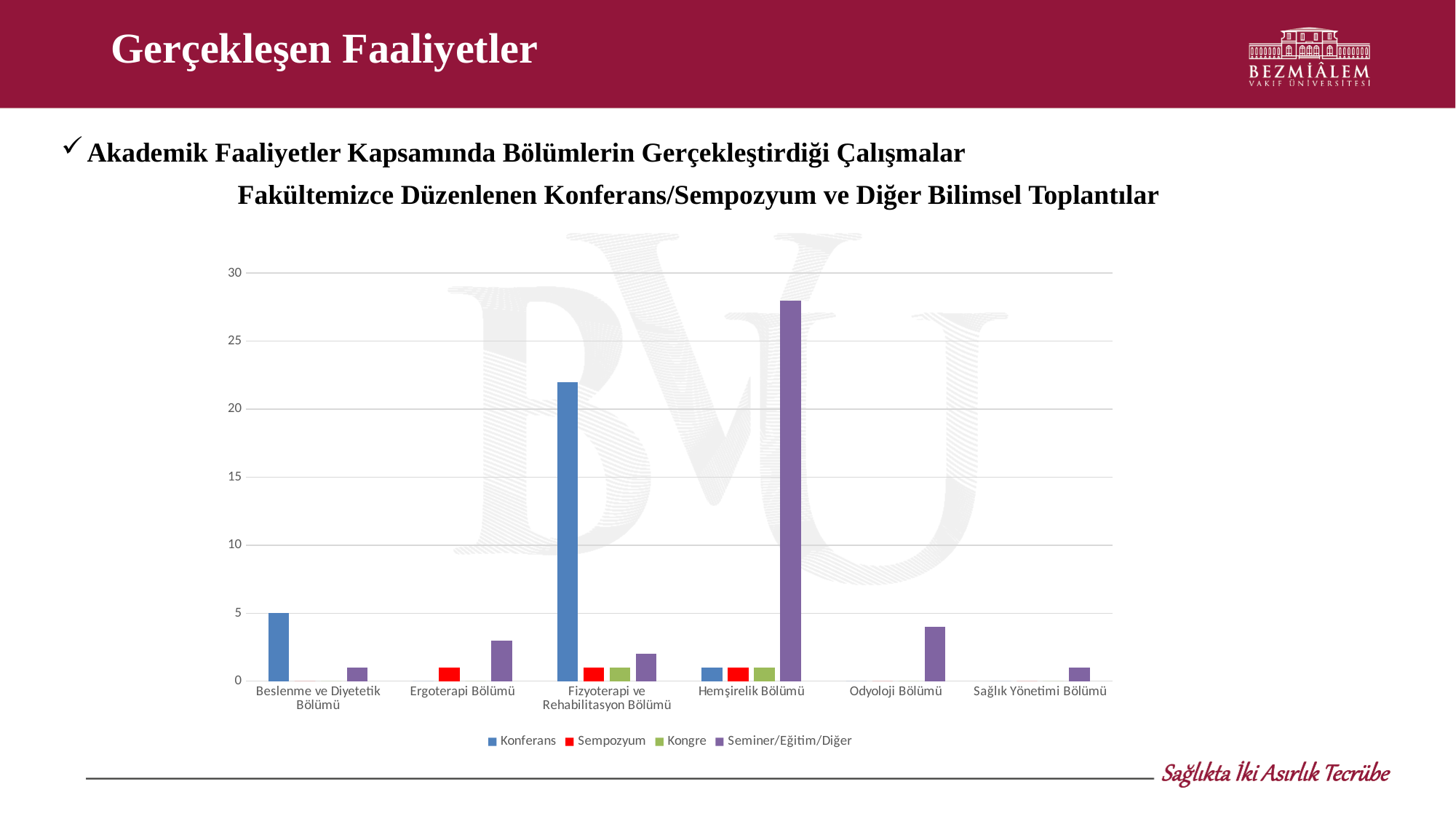
Which department has the highest Konferans value? Fizyoterapi ve Rehabilitasyon Bölümü Is the Seminer/Eğitim/Diğer value for Hemşirelik Bölümü greater or less than 25? greater Is the Konferans value for Fizyoterapi ve Rehabilitasyon Bölümü greater or less than 20? greater How many departments (categories) are shown on the x axis? 6 Is the Seminer/Eğitim/Diğer value for Odyoloji Bölümü greater or less than 5? less What is the title of the chart? Fakültemizce Düzenlenen Konferans/Sempozyum ve Diğer Bilimsel Toplantılar What kind of chart is shown on the slide? bar chart How many series does the legend list? 4 Which is larger: the Konferans value for Fizyoterapi ve Rehabilitasyon Bölümü or the Seminer/Eğitim/Diğer value for Hemşirelik Bölümü? Seminer/Eğitim/Diğer value for Hemşirelik Bölümü What is the Konferans value for Beslenme ve Diyetetik Bölümü? 5 What colour represents the Sempozyum series in the legend? red Which department has the highest Seminer/Eğitim/Diğer value? Hemşirelik Bölümü